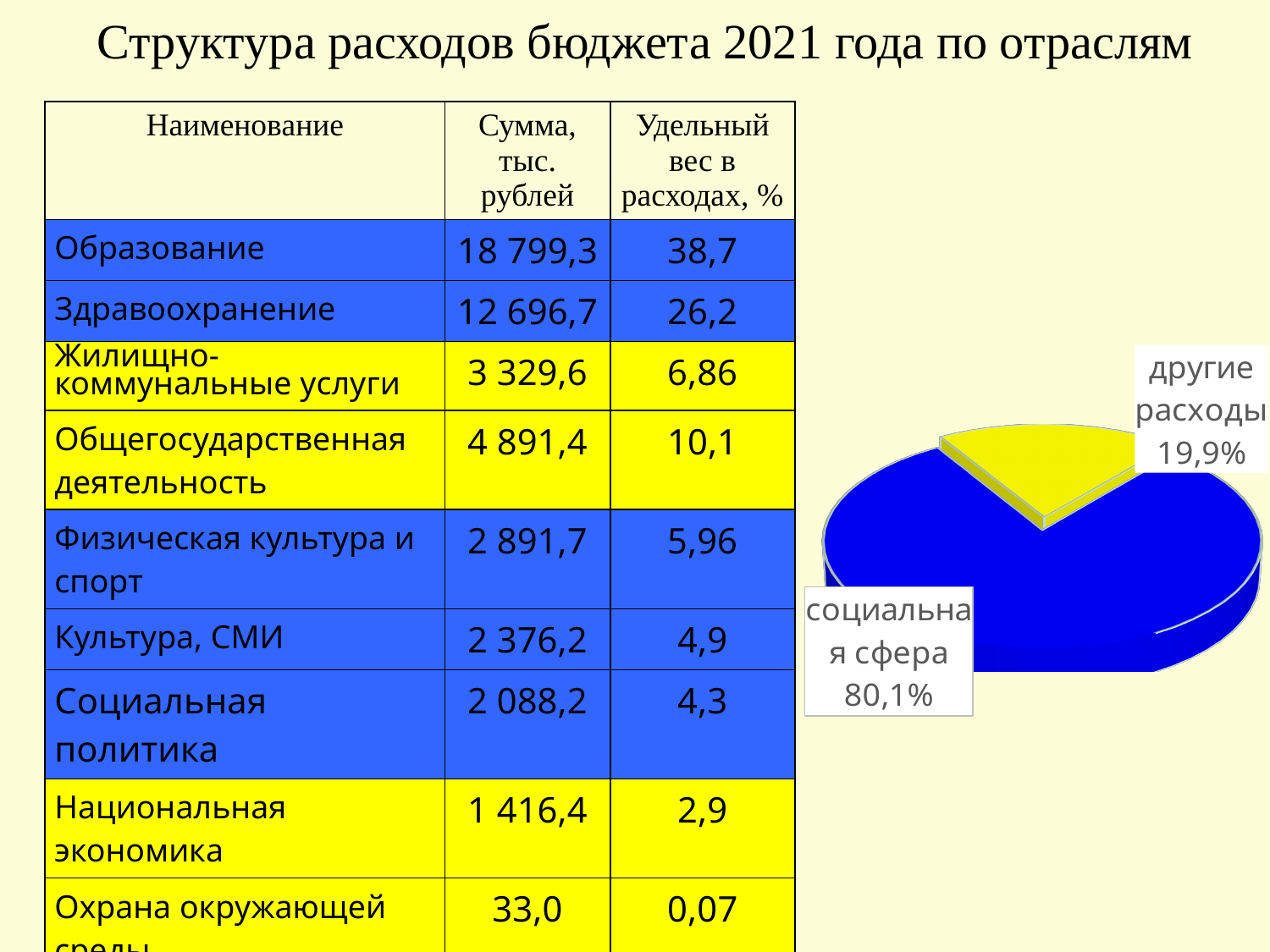
What is the value printed on the pie chart for «другие расходы»? 19,9% Which slice of the pie chart is the largest? социальная сфера What is the value printed on the pie chart for «социальная сфера»? 80,1% What share of the pie chart does «социальная сфера» account for? 80,1% By how many percentage points does «социальная сфера» exceed «другие расходы» in the pie chart? 60,2 Which slice of the pie chart is the smallest? другие расходы What share of the pie chart does «другие расходы» account for? 19,9% How many slices does the pie chart have? 2 What kind of chart is shown on the slide? pie chart What colour is the «другие расходы» slice in the pie chart? yellow In the pie chart, which is larger: «социальная сфера» or «другие расходы»? социальная сфера What colour is the «социальная сфера» slice in the pie chart? blue